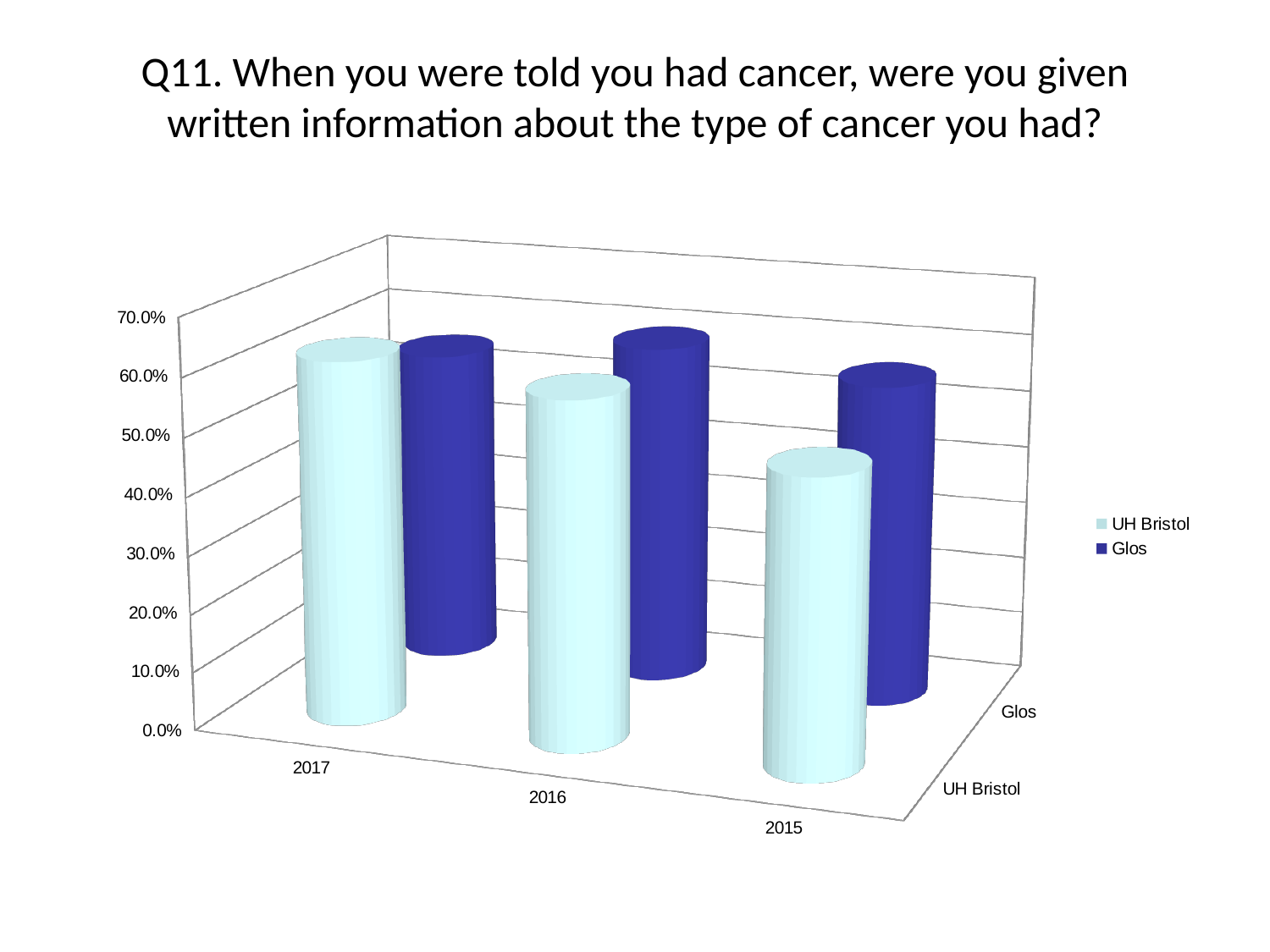
How many year categories are shown on the x axis? 3 Is the value for Glos in 2015 greater or less than 70.0%? less For the UH Bristol series, which year has the lowest value? 2015 Which series is shown in light blue? UH Bristol Do the UH Bristol values rise or fall moving along the x axis from 2017 to 2015? fall Which series is shown in dark blue? Glos Is the value for Glos in 2016 greater or less than 40.0%? greater How many series does the legend list? 2 Is the value for UH Bristol in 2017 greater or less than 50.0%? greater What kind of chart is shown on the slide? bar chart For UH Bristol, which is larger: the value for 2017 or the value for 2015? 2017